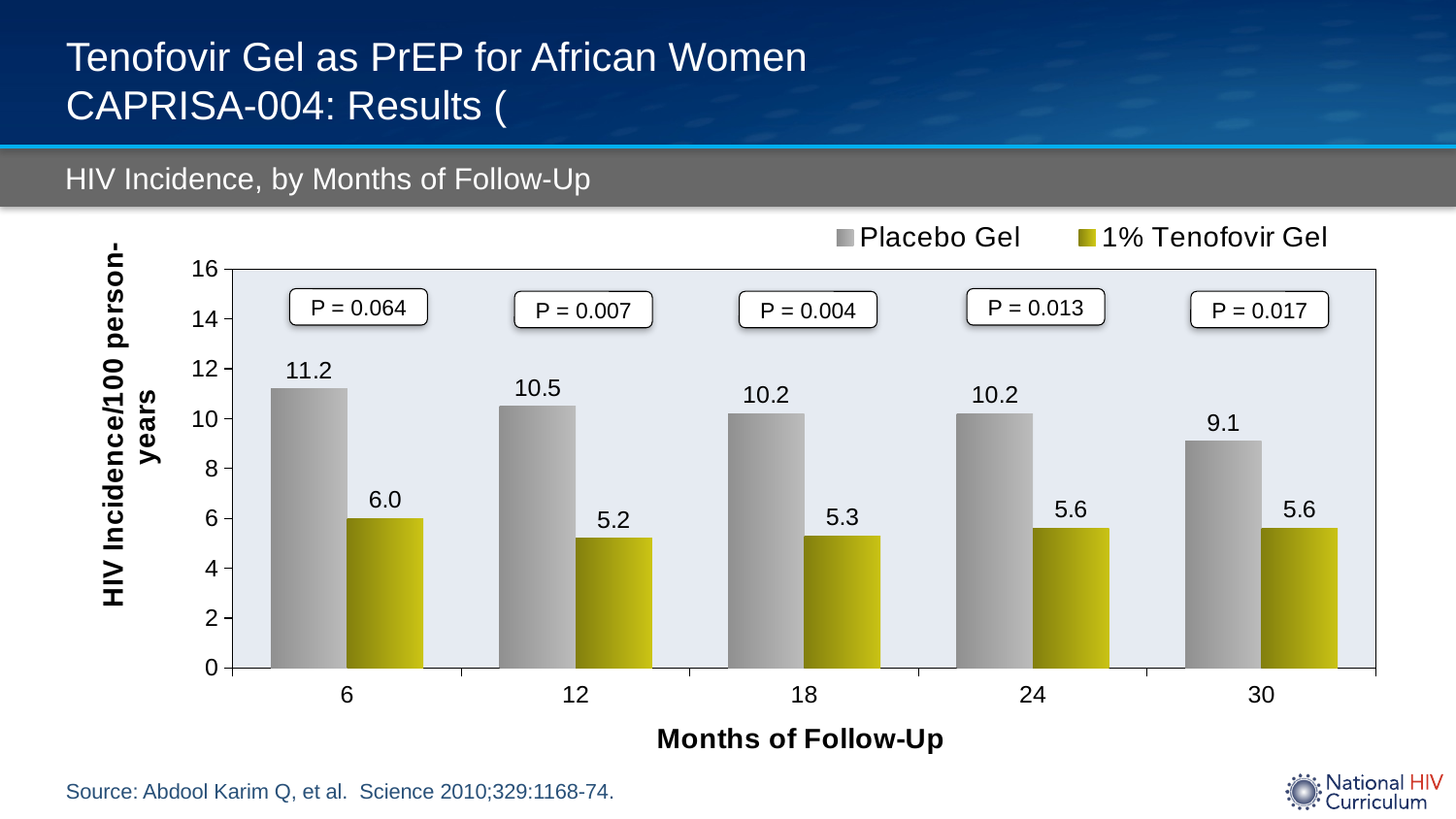
Which has the higher HIV incidence at 24 months, Placebo Gel or 1% Tenofovir Gel? Placebo Gel How many months-of-follow-up categories are shown on the x axis? 5 How many series does the legend list? 2 What kind of chart is shown on the slide? Bar chart What is the HIV incidence for Placebo Gel at 6 months of follow-up? 11.2 At which month of follow-up is the 1% Tenofovir Gel HIV incidence lowest? 12 What P value is shown for the 18-month follow-up comparison? P = 0.004 What is the HIV incidence for 1% Tenofovir Gel at 12 months of follow-up? 5.2 Is the Placebo Gel HIV incidence at 30 months greater or less than 10? less At which month of follow-up is the Placebo Gel HIV incidence highest? 6 What is the HIV incidence for 1% Tenofovir Gel at 30 months of follow-up? 5.6 What is the difference between the Placebo Gel and 1% Tenofovir Gel HIV incidence at 18 months? 4.9